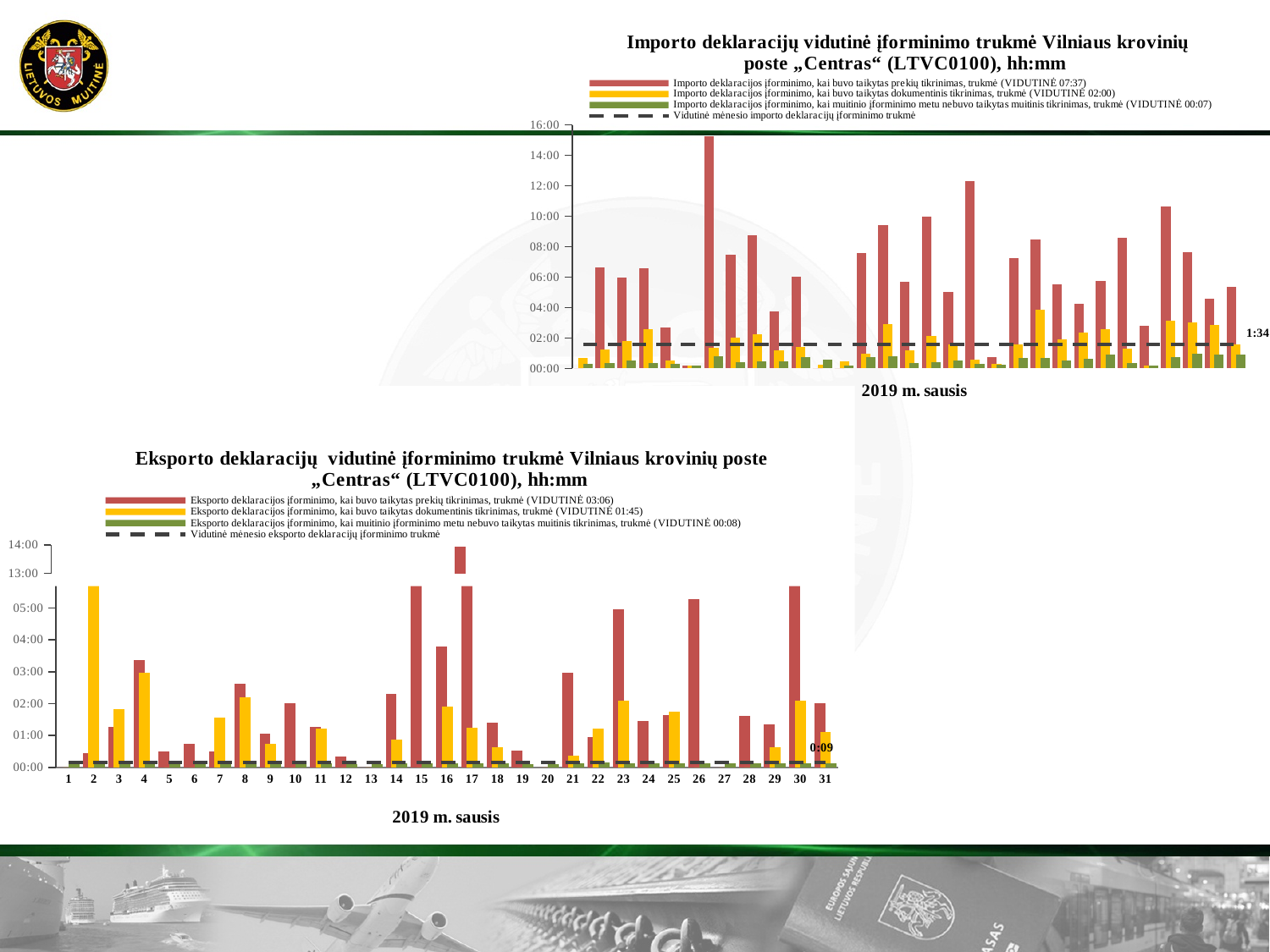
How many series does the legend of the top (Importo) chart list? 4 How many series does the legend of the bottom (Eksporto) chart list? 4 In the top (Importo) chart, what value is labelled on the dashed monthly average line? 1:34 In the bottom (Eksporto) chart, what value is labelled on the dashed monthly average line? 0:09 How many days (categories) are shown on the x axis of the bottom (Eksporto) chart? 31 In the bottom (Eksporto) chart, is the red bar for day 1 greater or less than 01:00? less In the bottom (Eksporto) chart, on which day is the yellow bar (dokumentinis tikrinimas) the highest? 2 What kind of chart is the bottom chart titled "Eksporto deklaracijų vidutinė įforminimo trukmė"? bar chart In the top (Importo) chart, is the tallest red bar greater or less than 14:00? greater In the bottom (Eksporto) chart, on which day is the red bar (prekių tikrinimas) the highest? 17 In the bottom (Eksporto) chart, which is larger on day 2: the red bar or the yellow bar? the yellow bar In the bottom (Eksporto) chart, is the red bar for day 15 greater or less than 04:00? greater